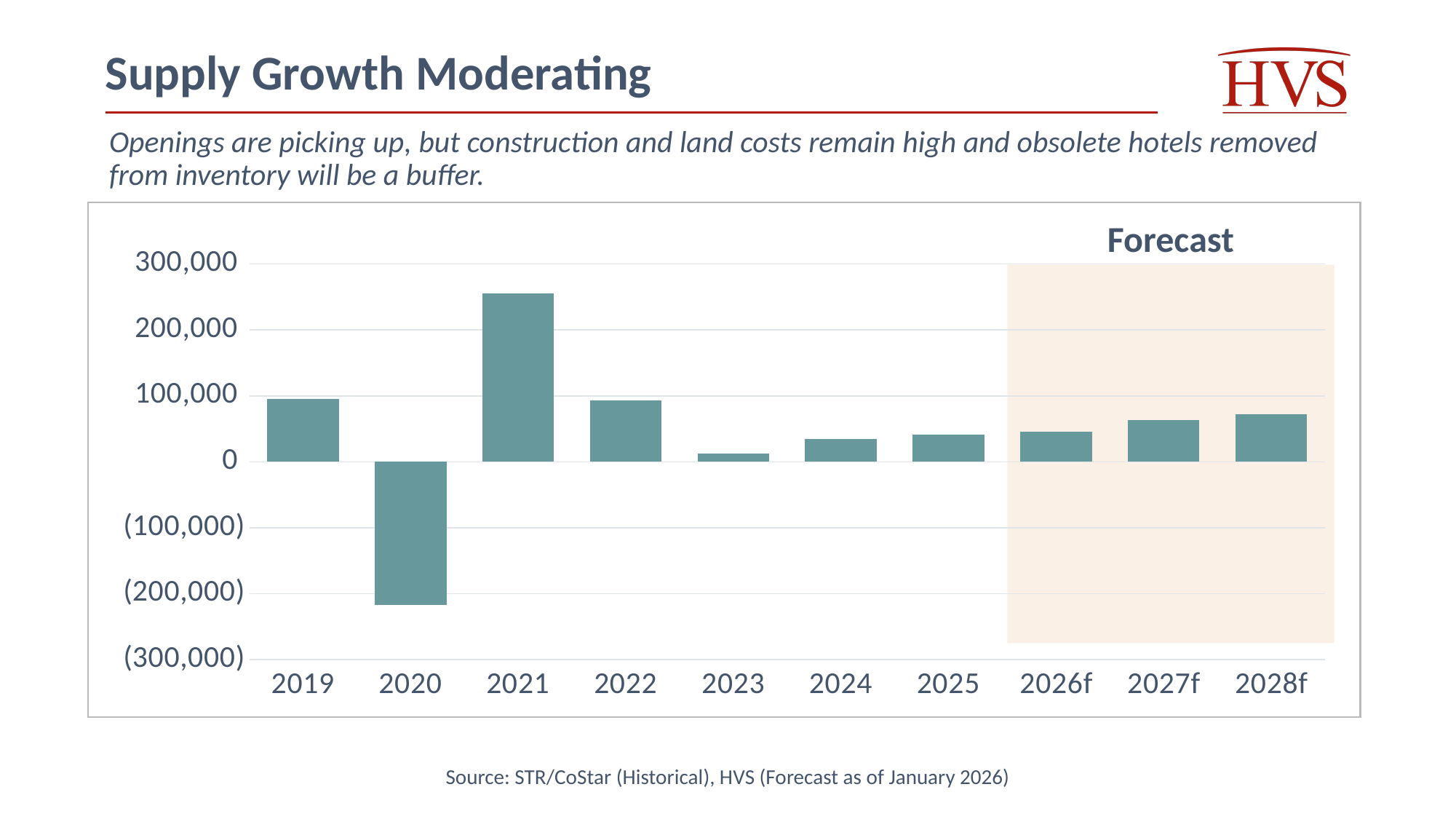
Which years are shaded as forecast on the chart? 2026f, 2027f, 2028f What kind of chart is shown on the slide? bar chart Which year has the highest value? 2021 Which is larger, the value for 2021 or the value for 2019? 2021 Is the value for 2023 greater or less than 100,000? less Do the values rise or fall from 2023 through 2028f? rise Is the value for 2020 greater or less than (100,000)? less How many years (categories) are plotted on the x axis? 10 Is the value for 2021 greater or less than 200,000? greater Which year has the lowest value? 2020 Which is larger, the value for 2028f or the value for 2023? 2028f